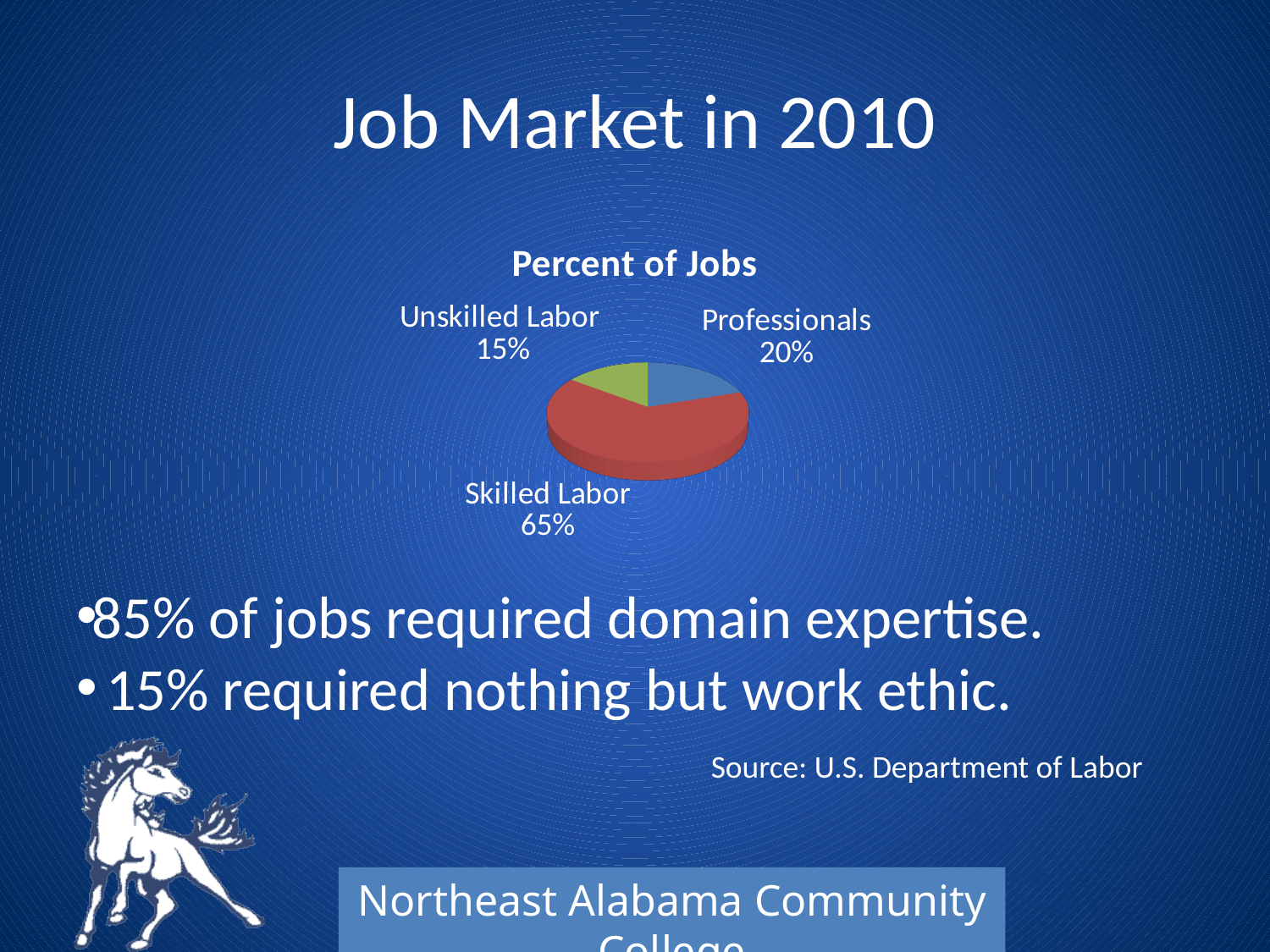
What is the difference in percentage points between Skilled Labor and Professionals? 45 What percentage of jobs is shown for Skilled Labor? 65% Which is larger, the share for Professionals or the share for Unskilled Labor? Professionals What colour is the Skilled Labor slice? red Which category has the smallest share of the pie? Unskilled Labor What percentage of jobs is shown for Professionals? 20% What kind of chart is shown on the slide? pie chart What is the combined share of Skilled Labor and Professionals? 85% What is the title of the chart? Percent of Jobs How many slices does the pie chart have? 3 What percentage of jobs is shown for Unskilled Labor? 15% Which category has the largest share of the pie? Skilled Labor